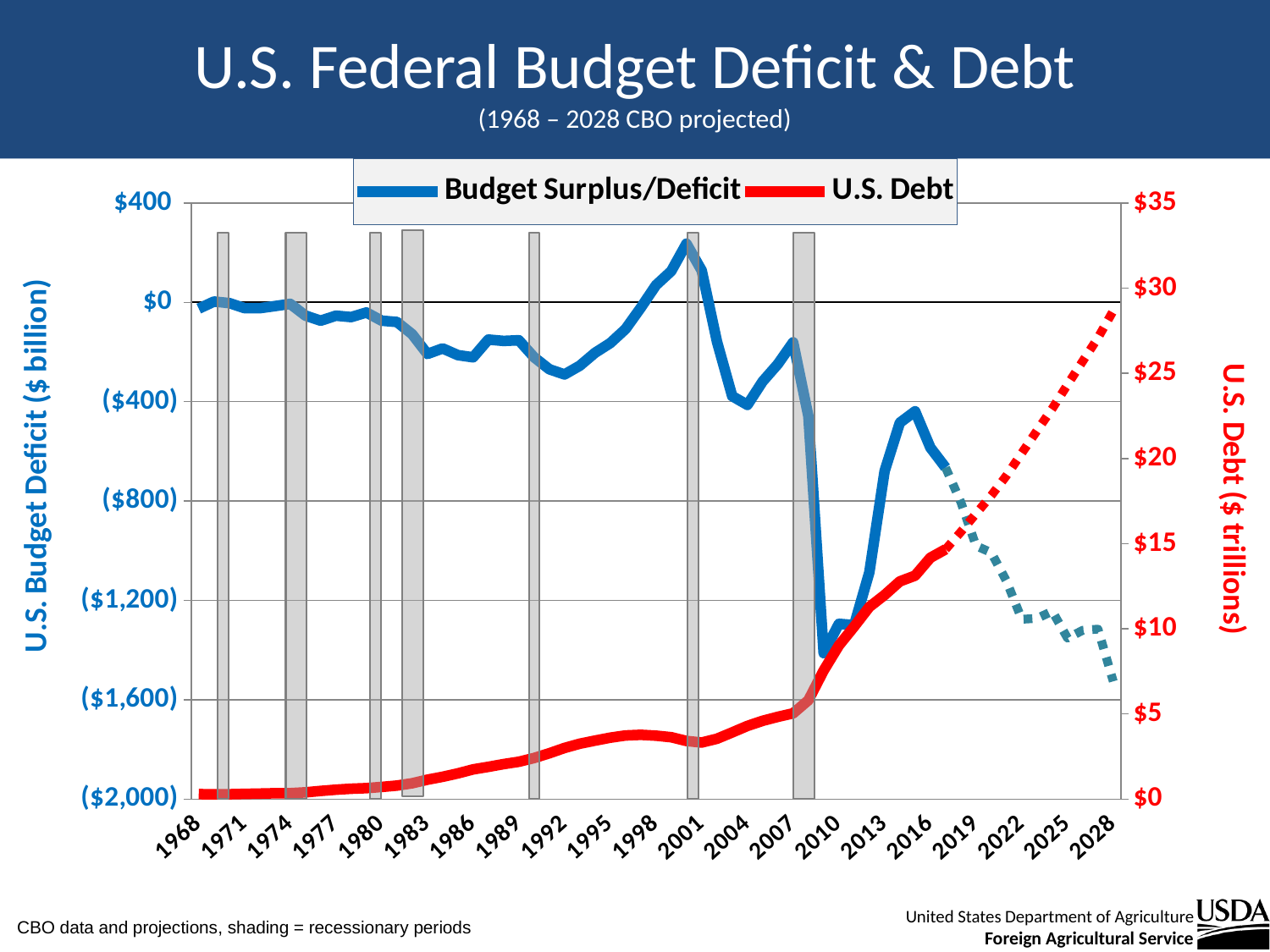
Is the U.S. Debt value for 2028 greater or less than $25 trillion? greater Does the U.S. Debt line generally rise or fall from 1968 to 2028? Rise What are the two series named in the legend? Budget Surplus/Deficit and U.S. Debt How many series does the legend list? 2 Which is larger, the U.S. Debt value in 2028 or in 2016? 2028 Does the projected Budget Surplus/Deficit line rise or fall from 2019 to 2028? Fall What is the label of the right-hand vertical axis? U.S. Debt ($ trillions) Is the Budget Surplus/Deficit value for 1992 greater or less than $0? less Is the Budget Surplus/Deficit value for 2010 greater or less than ($1,200) billion? less What kind of chart is shown on the slide? Line chart